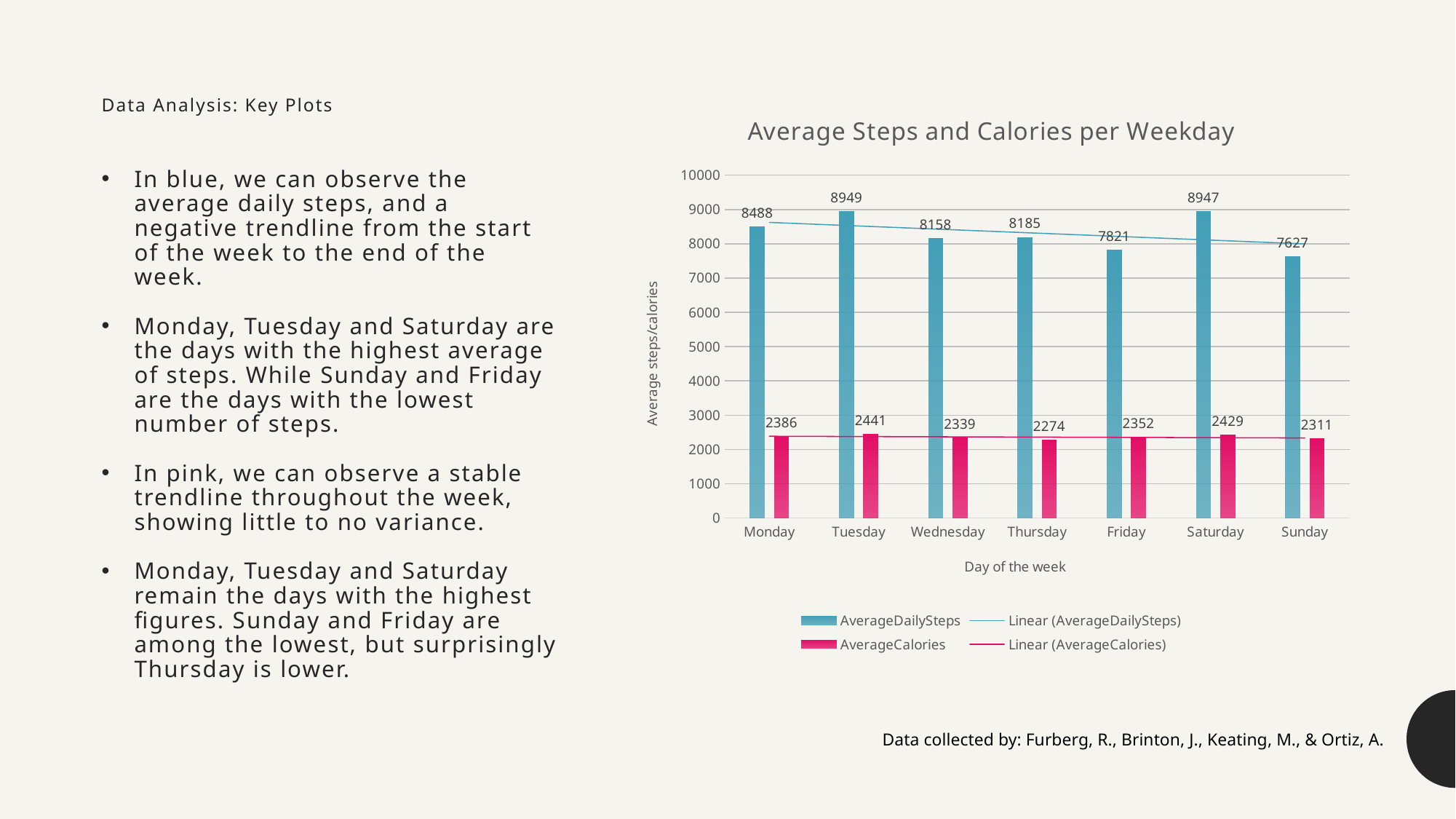
What is the AverageDailySteps value for Monday? 8488 Which day has the lowest AverageCalories value? Thursday What is the AverageCalories value for Thursday? 2274 What kind of chart is shown on the slide? bar chart Which day has the larger AverageDailySteps value, Monday or Friday? Monday What is the difference between the AverageDailySteps values for Tuesday and Sunday? 1322 What is the AverageDailySteps value for Sunday? 7627 What is the title of the chart? Average Steps and Calories per Weekday How many entries does the legend list? 4 Is the AverageDailySteps value for Friday greater or less than 8000? less Which day has the lowest AverageDailySteps value? Sunday How many days of the week are shown on the x axis? 7